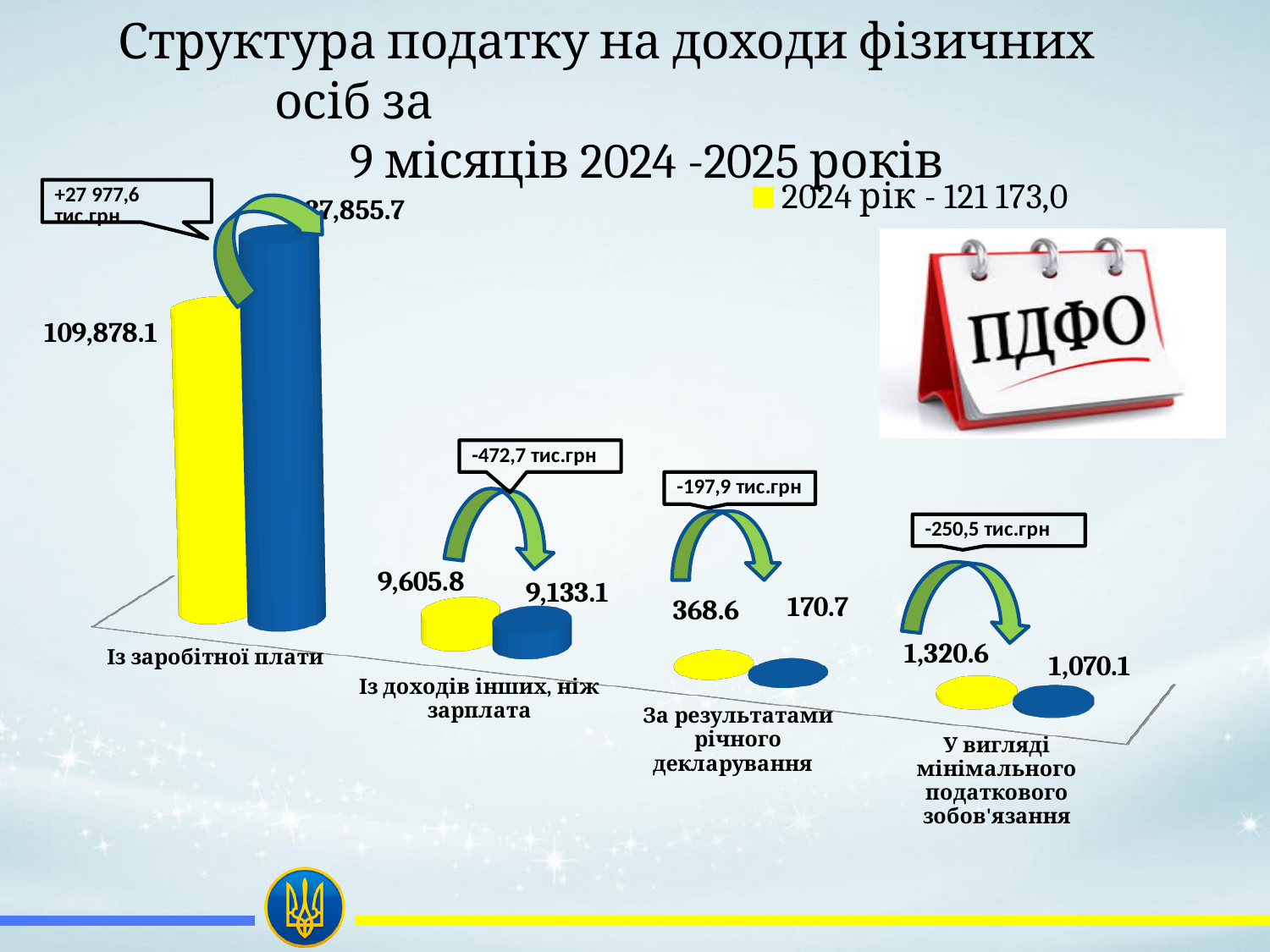
What is the yellow (2024) value for "За результатами річного декларування"? 368.6 What is the blue (2025) value for the category "Із доходів інших, ніж зарплата"? 9,133.1 What total value is shown in the legend next to "2024 рік"? 121 173,0 What is the blue (2025) value for "У вигляді мінімального податкового зобов'язання"? 1,070.1 What is the difference between the yellow and blue values for "У вигляді мінімального податкового зобов'язання"? 250.5 What kind of chart is shown on the slide? Bar chart What is the difference between the yellow and blue values for "За результатами річного декларування"? 197.9 For "Із доходів інших, ніж зарплата", which is larger: the yellow (2024) value or the blue (2025) value? The yellow (2024) value What is the 2024 (yellow) value for the category "Із заробітної плати"? 109,878.1 Which category has the highest values in the chart? Із заробітної плати Which category has the lowest yellow (2024) value? За результатами річного декларування How many categories are shown on the chart? 4